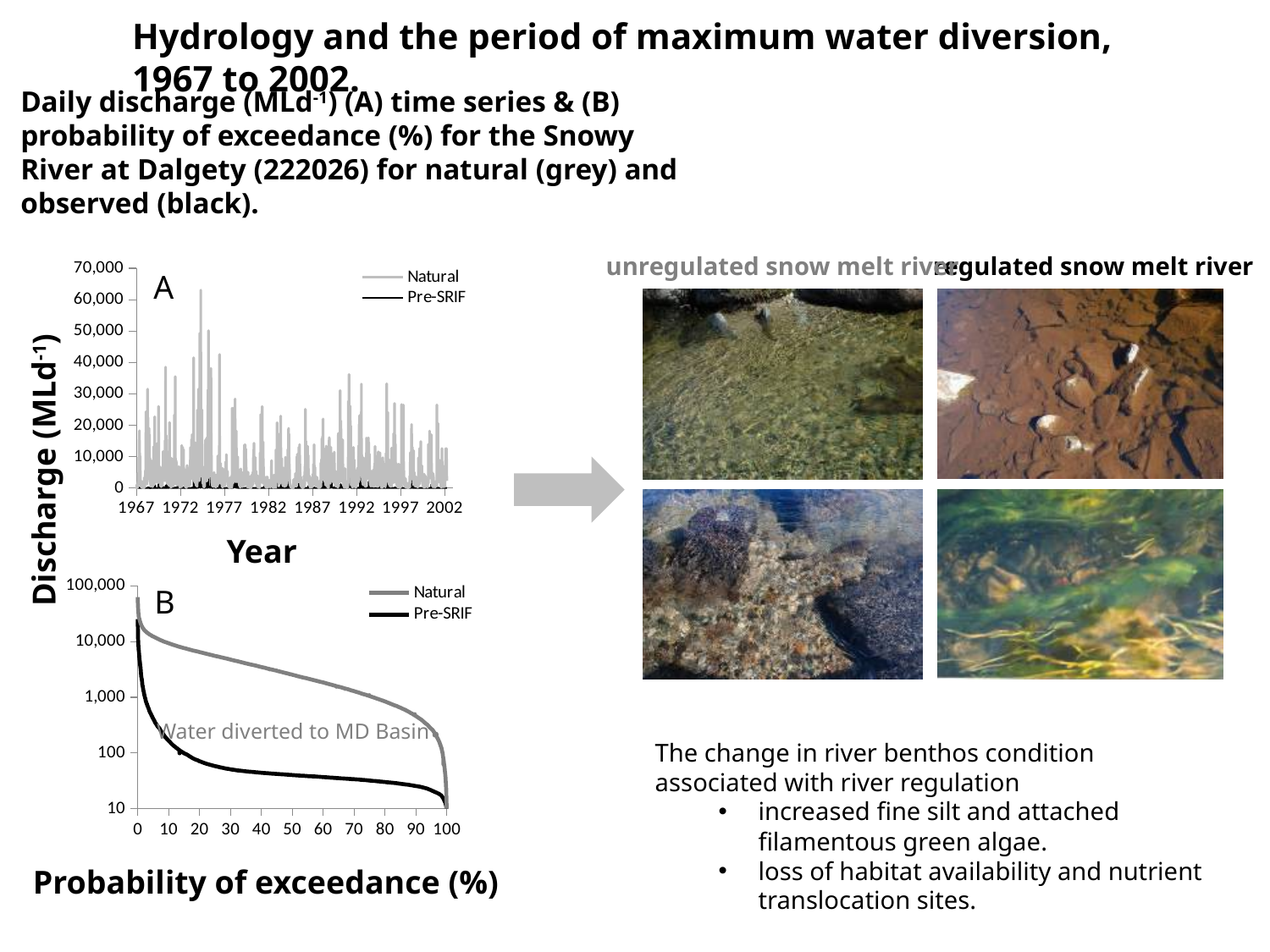
In chart B, at a probability of exceedance of 20%, which series has the larger discharge, Natural or Pre-SRIF? Natural What are the two series named in the legend of chart B? Natural and Pre-SRIF In chart A, is the highest peak of the Natural series greater or less than 50,000? greater In chart B, which colour is used for the Natural series? grey What kind of chart is chart A (the top chart)? line chart In chart B, at a probability of exceedance of 50%, is the Natural discharge greater or less than 1,000? greater In chart A, is the highest value of the Pre-SRIF series greater or less than 20,000? less What is the first year labelled on the x axis of chart A? 1967 How many series does the legend of chart A list? 2 In chart B, do the discharge values rise or fall as the probability of exceedance increases? fall In chart A, which series reaches higher discharge values, Natural or Pre-SRIF? Natural